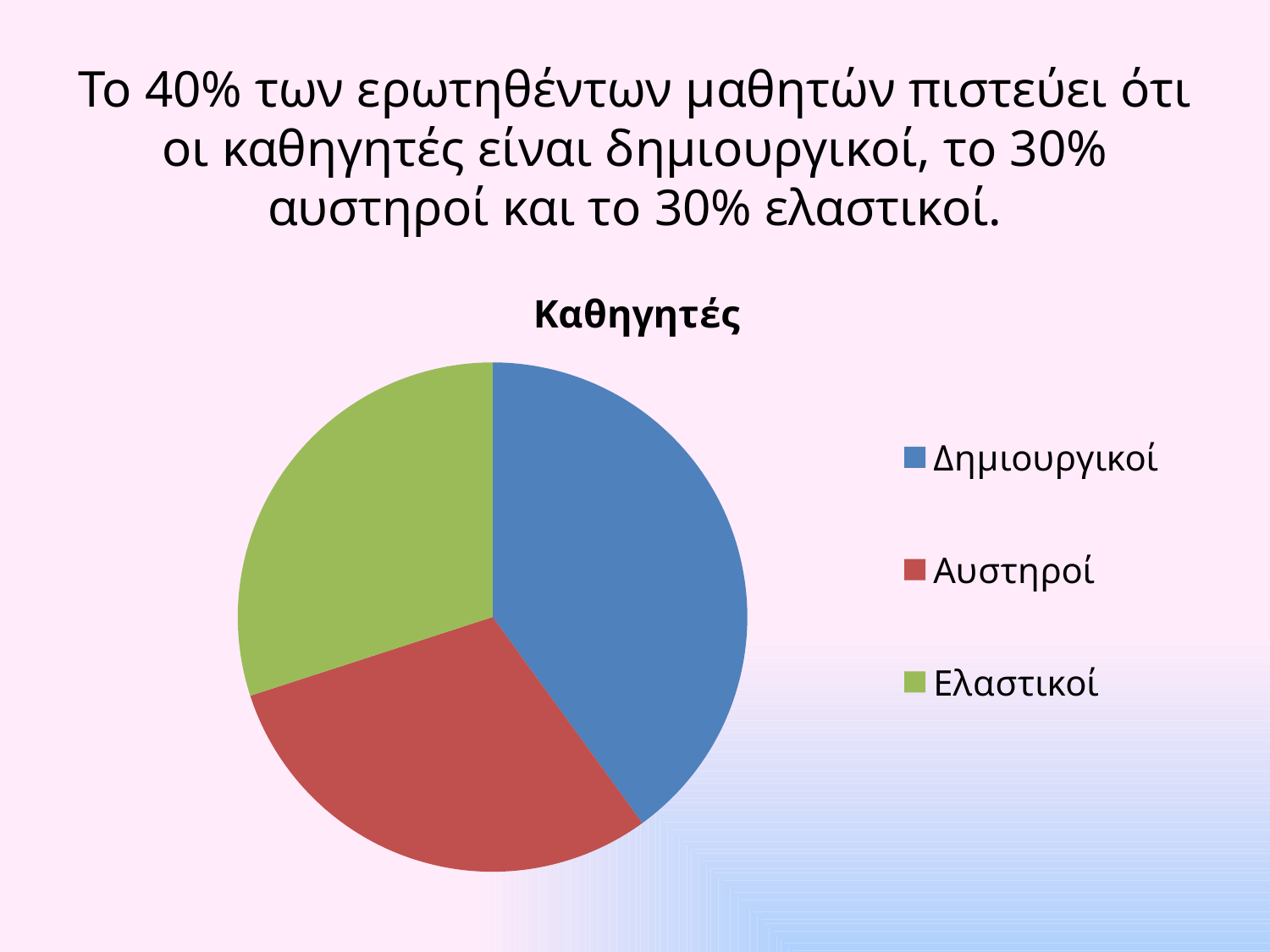
How many slices does the pie chart have? 3 What share of the pie does the Ελαστικοί slice represent? 30% Which slice is larger, Ελαστικοί or Δημιουργικοί? Δημιουργικοί What is the difference in percentage points between the Δημιουργικοί and Αυστηροί slices? 10% What share of the pie does the Δημιουργικοί slice represent? 40% Which slice is larger, Δημιουργικοί or Αυστηροί? Δημιουργικοί Which category has the largest slice of the pie? Δημιουργικοί What is the title of the chart? Καθηγητές What colour is the Δημιουργικοί slice in the pie chart? blue What kind of chart is shown on the slide? pie chart What share of the pie does the Αυστηροί slice represent? 30% How many entries does the chart legend list? 3